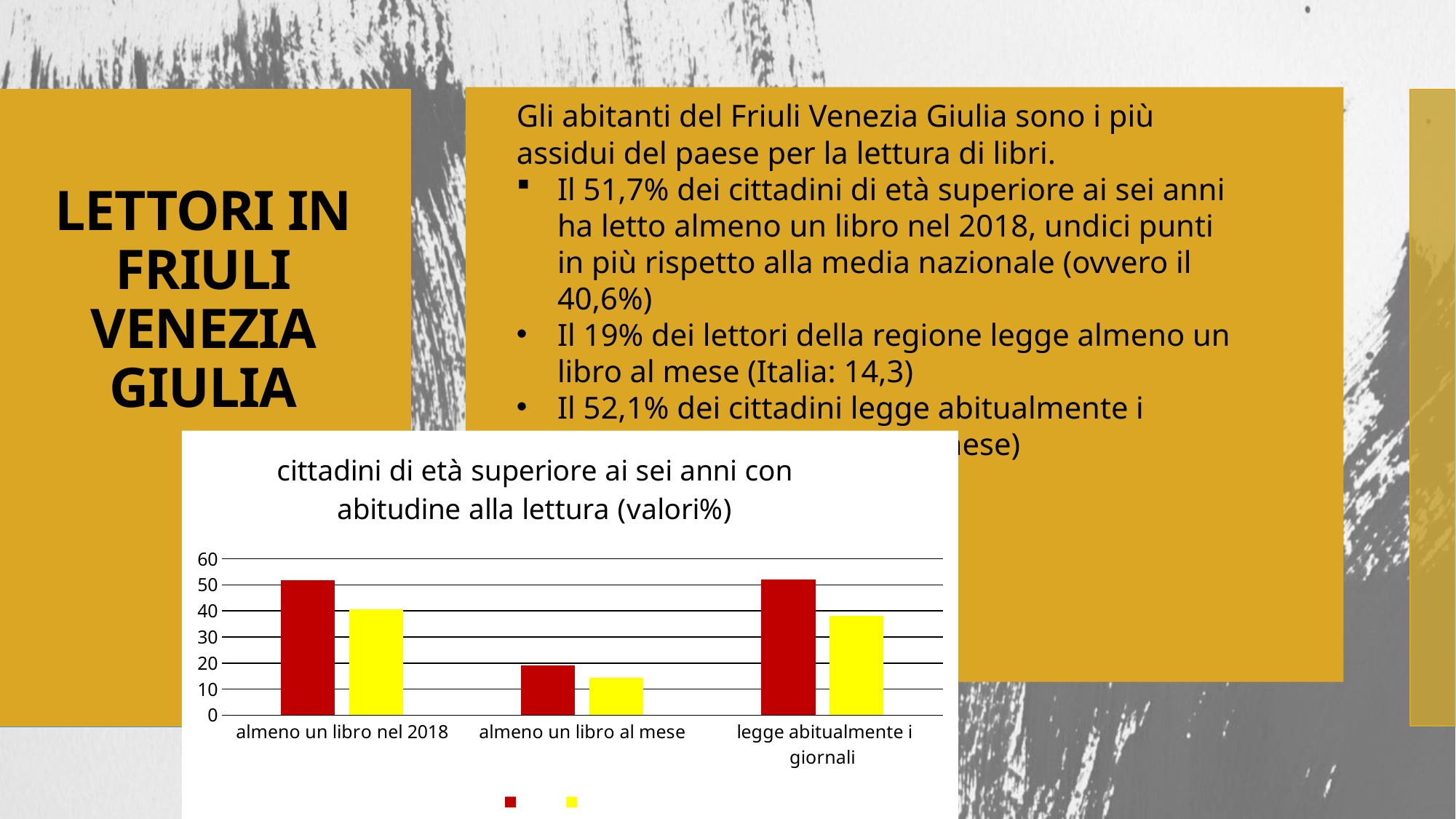
Which category has the lowest red bar? almeno un libro al mese Is the yellow bar for "almeno un libro al mese" greater or less than 20? less What colours are the two series in the chart? red and yellow How many categories are shown on the x axis of the chart? 3 Which is larger: the red bar for "almeno un libro al mese" or the red bar for "legge abitualmente i giornali"? legge abitualmente i giornali Is the yellow bar for "legge abitualmente i giornali" greater or less than 30? greater How many series does the chart's legend list? 2 What is the title of the chart? cittadini di età superiore ai sei anni con abitudine alla lettura (valori%) What kind of chart is shown on the slide? bar chart Is the red bar for "almeno un libro nel 2018" greater or less than 40? greater For "almeno un libro nel 2018", which bar is taller, the red one or the yellow one? the red one